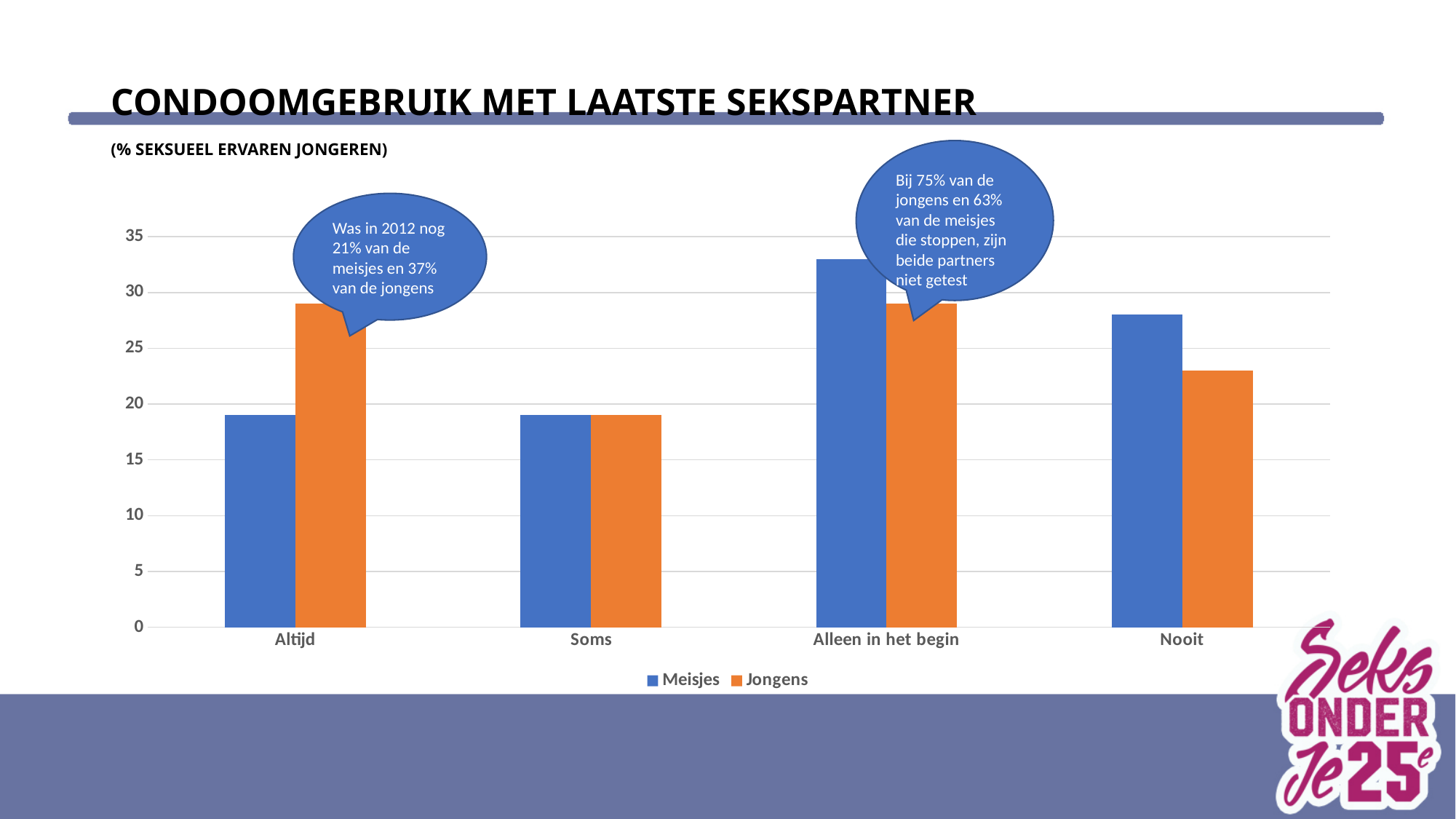
For the category Altijd, which series has the larger value, Meisjes or Jongens? Jongens For which category is the Meisjes bar the highest? Alleen in het begin For the category Nooit, which series has the larger value, Meisjes or Jongens? Meisjes What is the title of the chart on the slide? CONDOOMGEBRUIK MET LAATSTE SEKSPARTNER Is the Jongens value for Altijd greater or less than 25? greater What kind of chart is shown on the slide? bar chart For which category is the Jongens bar the lowest? Soms How many categories are shown on the x axis of the chart? 4 How many series does the chart legend list? 2 Is the Meisjes value for Alleen in het begin greater or less than 30? greater Which series is shown in orange in the chart? Jongens Is the Jongens value for Nooit greater or less than 25? less